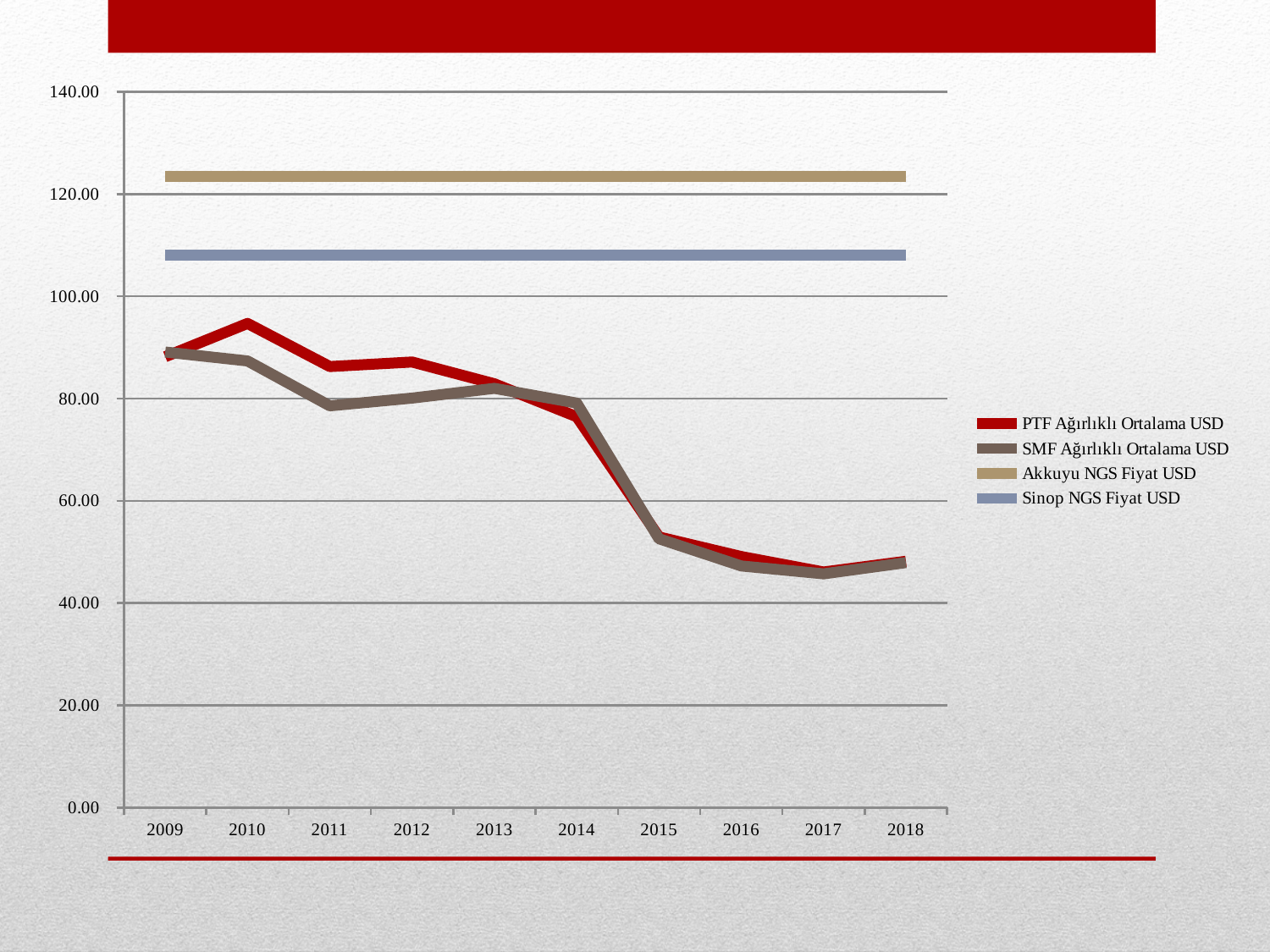
Is the value for Akkuyu NGS Fiyat USD greater or less than 120? greater Which is higher, Akkuyu NGS Fiyat USD or Sinop NGS Fiyat USD? Akkuyu NGS Fiyat USD In which year is SMF Ağırlıklı Ortalama USD at its lowest? 2017 Which series is drawn in red? PTF Ağırlıklı Ortalama USD In which year is PTF Ağırlıklı Ortalama USD at its highest? 2010 Is the value for PTF Ağırlıklı Ortalama USD in 2010 greater or less than 80? greater How many series does the legend list? 4 What kind of chart is shown on the slide? line chart Is the value for Sinop NGS Fiyat USD greater or less than 100? greater How many years are shown on the x axis? 10 Does the PTF Ağırlıklı Ortalama USD line rise or fall from 2009 to 2018? fall